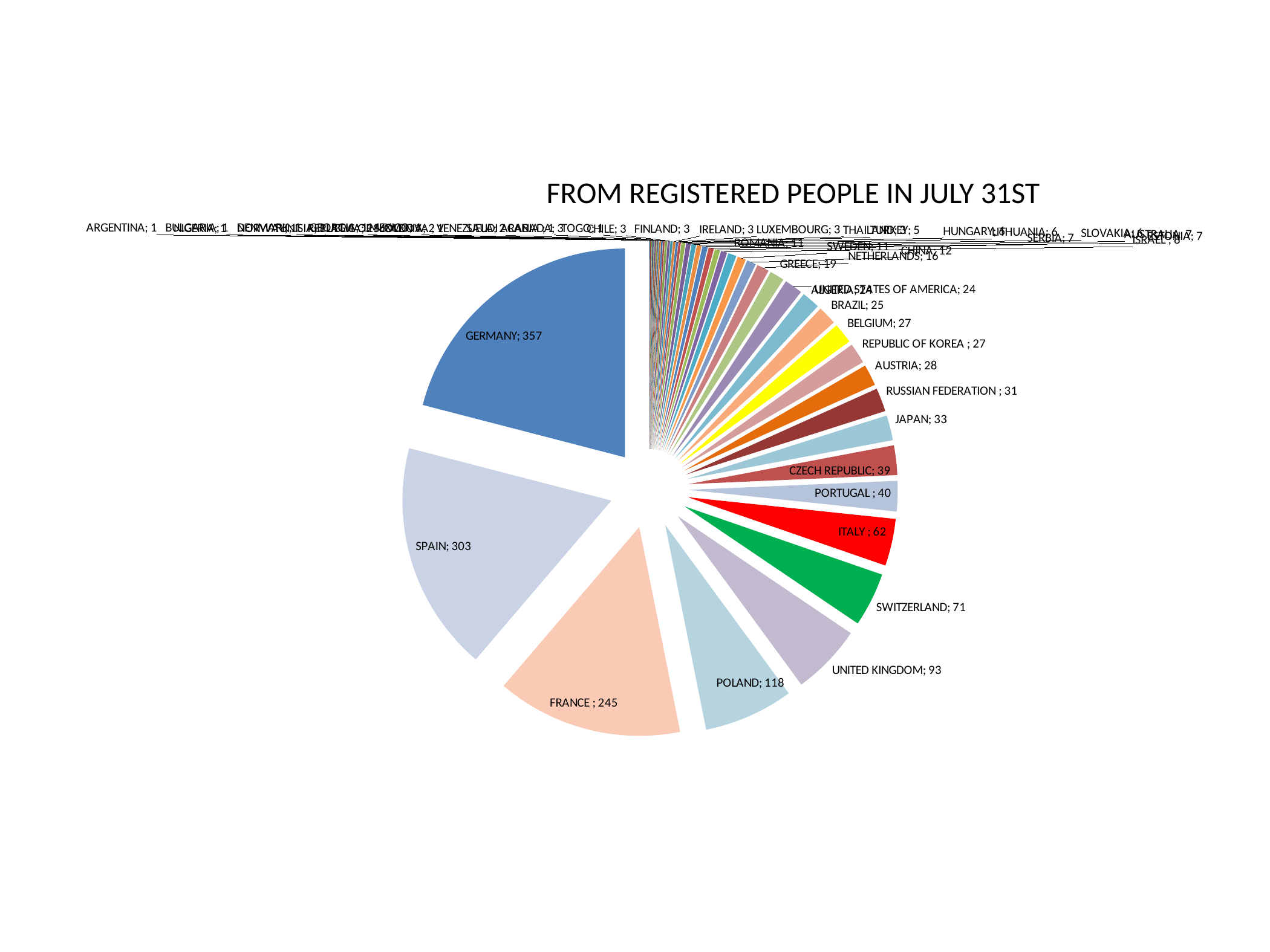
What is the title of the chart? FROM REGISTERED PEOPLE IN JULY 31ST What is the value shown for GERMANY? 357 What kind of chart is shown on the slide? pie chart What is the value shown for ITALY? 62 Which has a larger value, POLAND or UNITED KINGDOM? POLAND Which country has the largest slice in the pie chart? GERMANY What is the value shown for SWITZERLAND? 71 What is the value shown for POLAND? 118 What is the difference between the values for GERMANY and SPAIN? 54 What is the value shown for JAPAN? 33 What is the value shown for SPAIN? 303 What is the value shown for FRANCE? 245